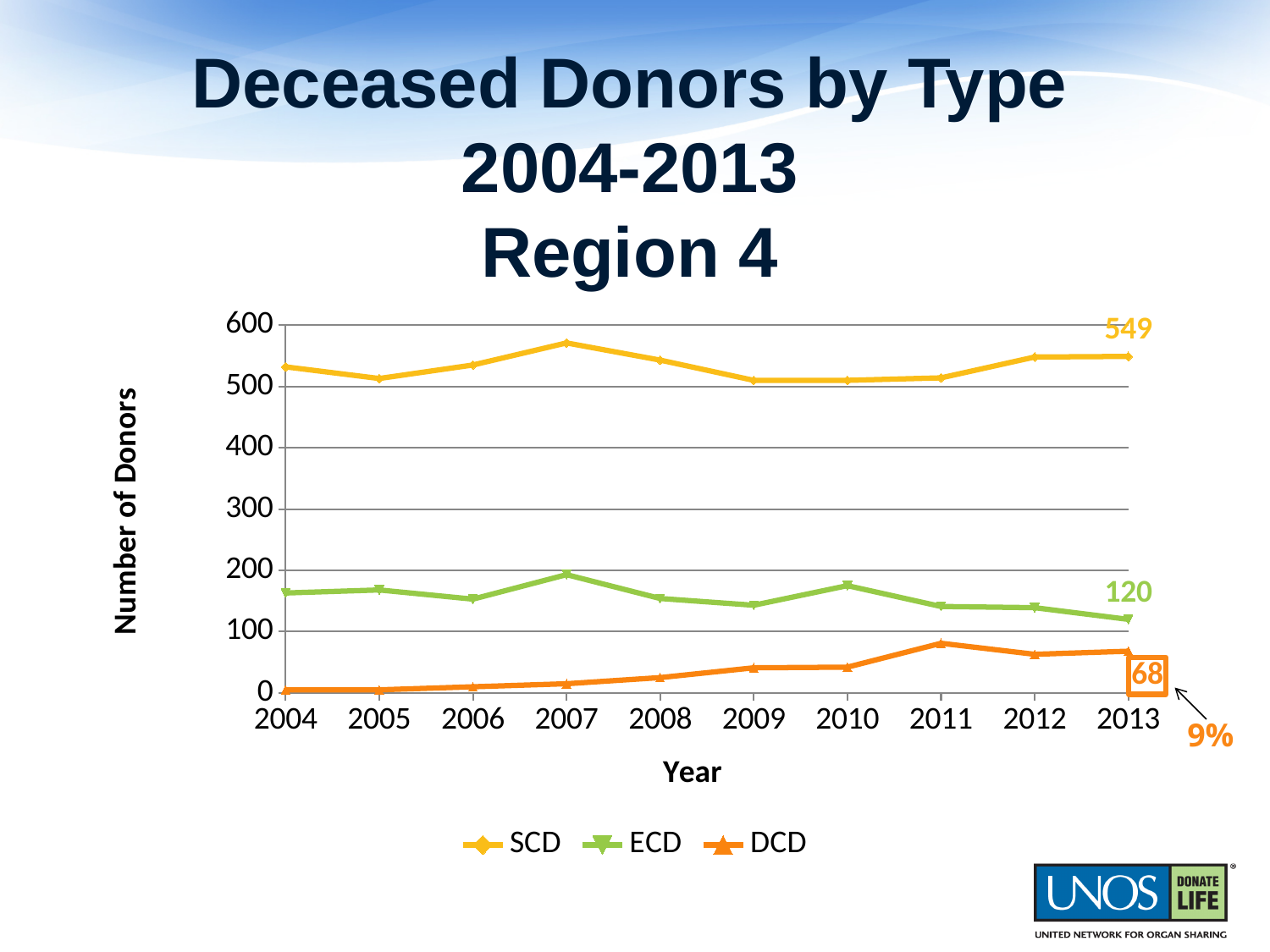
Which series has the highest values across all years? SCD Which series has the lowest values across all years? DCD How many years are plotted along the x axis? 10 Is the DCD value for 2011 greater or less than 100? less Is the SCD value for 2007 greater or less than 500? greater How many series does the legend list? 3 What is the number of SCD donors in 2013? 549 What type of chart is shown on the slide? line chart What is the difference between the SCD and ECD values in 2013? 429 What is the number of DCD donors in 2013? 68 What is the number of ECD donors in 2013? 120 What percentage is annotated next to the DCD value for 2013? 9%